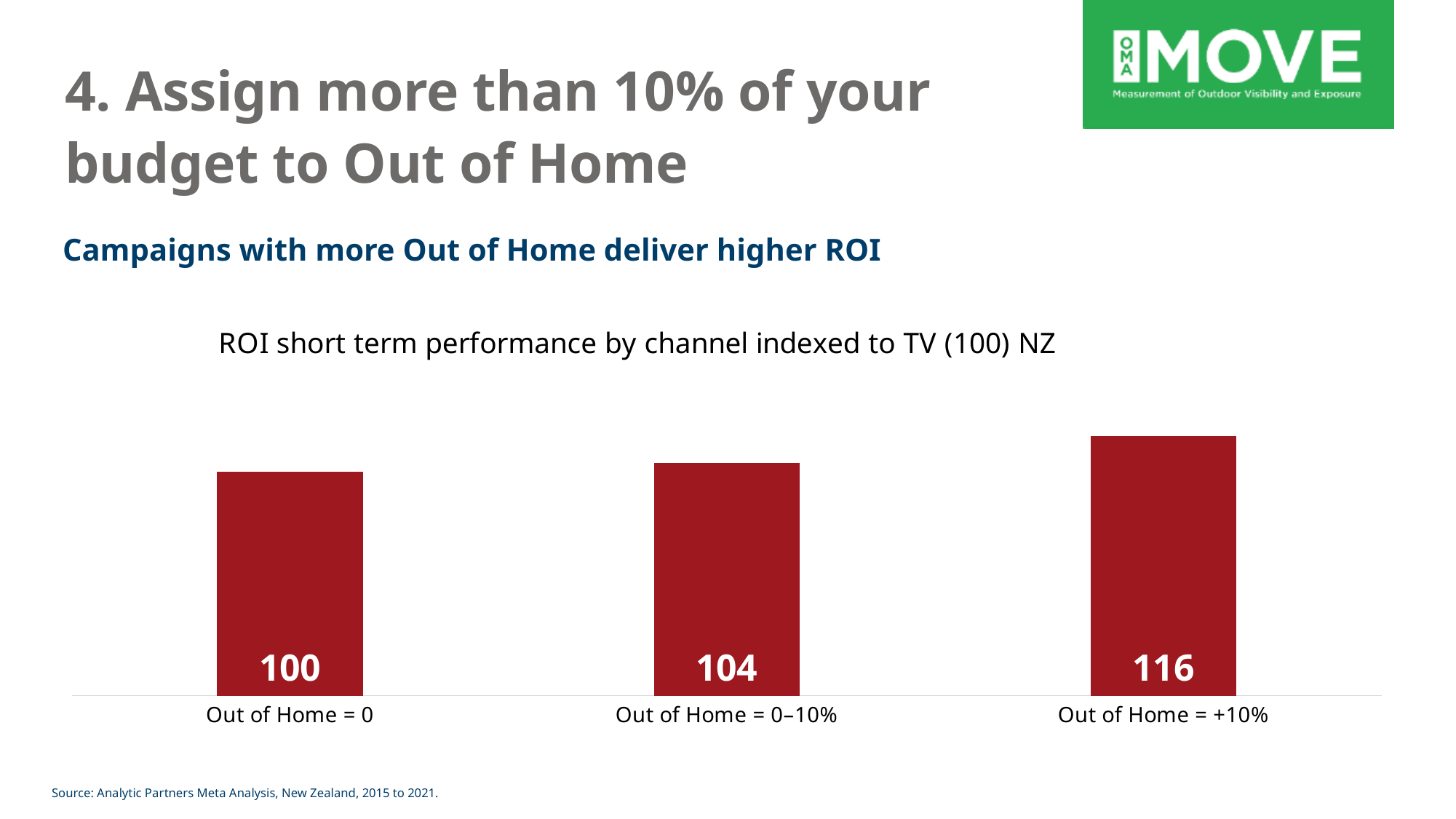
Which is larger, the ROI index for Out of Home = 0–10% or for Out of Home = +10%? Out of Home = +10% Do the ROI index values rise or fall from left to right across the categories? Rise Which category has the highest ROI index value? Out of Home = +10% What is the title of the chart? ROI short term performance by channel indexed to TV (100) NZ What is the difference between the ROI index for Out of Home = +10% and Out of Home = 0? 16 What kind of chart is shown on the slide? Bar chart What is the ROI index value for Out of Home = +10%? 116 How many categories are shown in the chart? 3 What is the ROI index value for Out of Home = 0–10%? 104 Which category has the lowest ROI index value? Out of Home = 0 What is the ROI index value for Out of Home = 0? 100 What is the difference between the ROI index for Out of Home = 0–10% and Out of Home = 0? 4